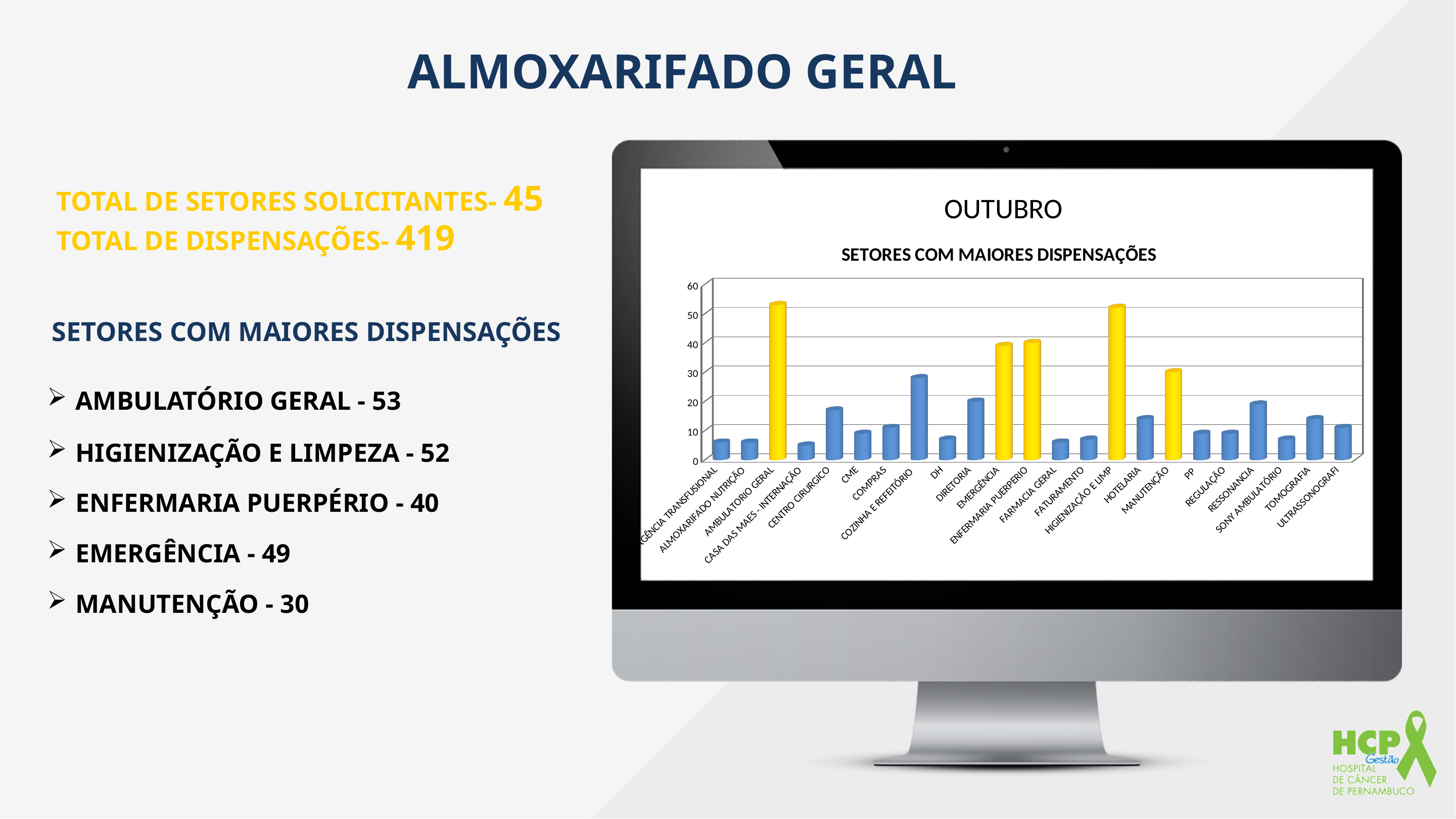
What is the value for AMBULATÓRIO GERAL? 53 What is the difference between the values for AMBULATÓRIO GERAL and MANUTENÇÃO? 23 How many bars in the chart are coloured yellow? 5 How many sectors (bars) are plotted in the chart? 23 What is the value for ENFERMARIA PUERPÉRIO? 40 Which has a larger value, MANUTENÇÃO or HOTELARIA? MANUTENÇÃO Which has a larger value, COZINHA E REFEITÓRIO or CENTRO CIRURGICO? COZINHA E REFEITÓRIO What kind of chart is shown on the monitor? bar chart What is the title shown above the chart on the monitor? OUTUBRO Is the value for COZINHA E REFEITÓRIO greater or less than 20? greater Is the value for CENTRO CIRURGICO greater or less than 20? less What is the value for MANUTENÇÃO? 30